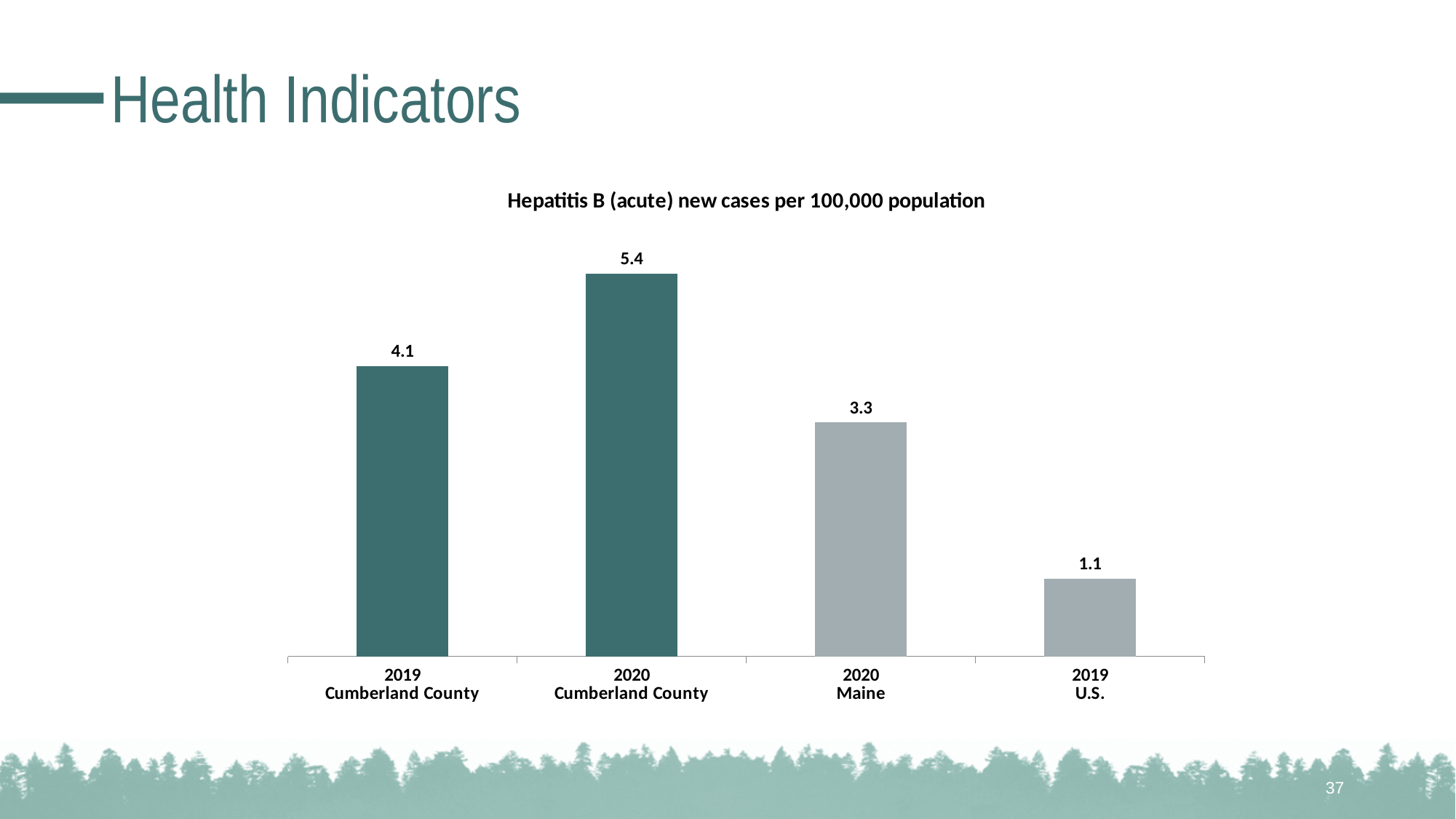
Which category has the lowest value? 2019 U.S. Which category has the highest value? 2020 Cumberland County How many categories are shown in the chart? 4 Which is larger, the value for 2020 Maine or the value for 2019 Cumberland County? 2019 Cumberland County What is the difference between the 2020 Maine value and the 2019 U.S. value? 2.2 What is the difference between the 2020 Cumberland County value and the 2019 Cumberland County value? 1.3 What kind of chart is shown on the slide? Bar chart What is the value for 2020 Cumberland County? 5.4 What is the title of the chart? Hepatitis B (acute) new cases per 100,000 population What is the value for 2019 U.S.? 1.1 What is the value for 2020 Maine? 3.3 What is the value for 2019 Cumberland County? 4.1